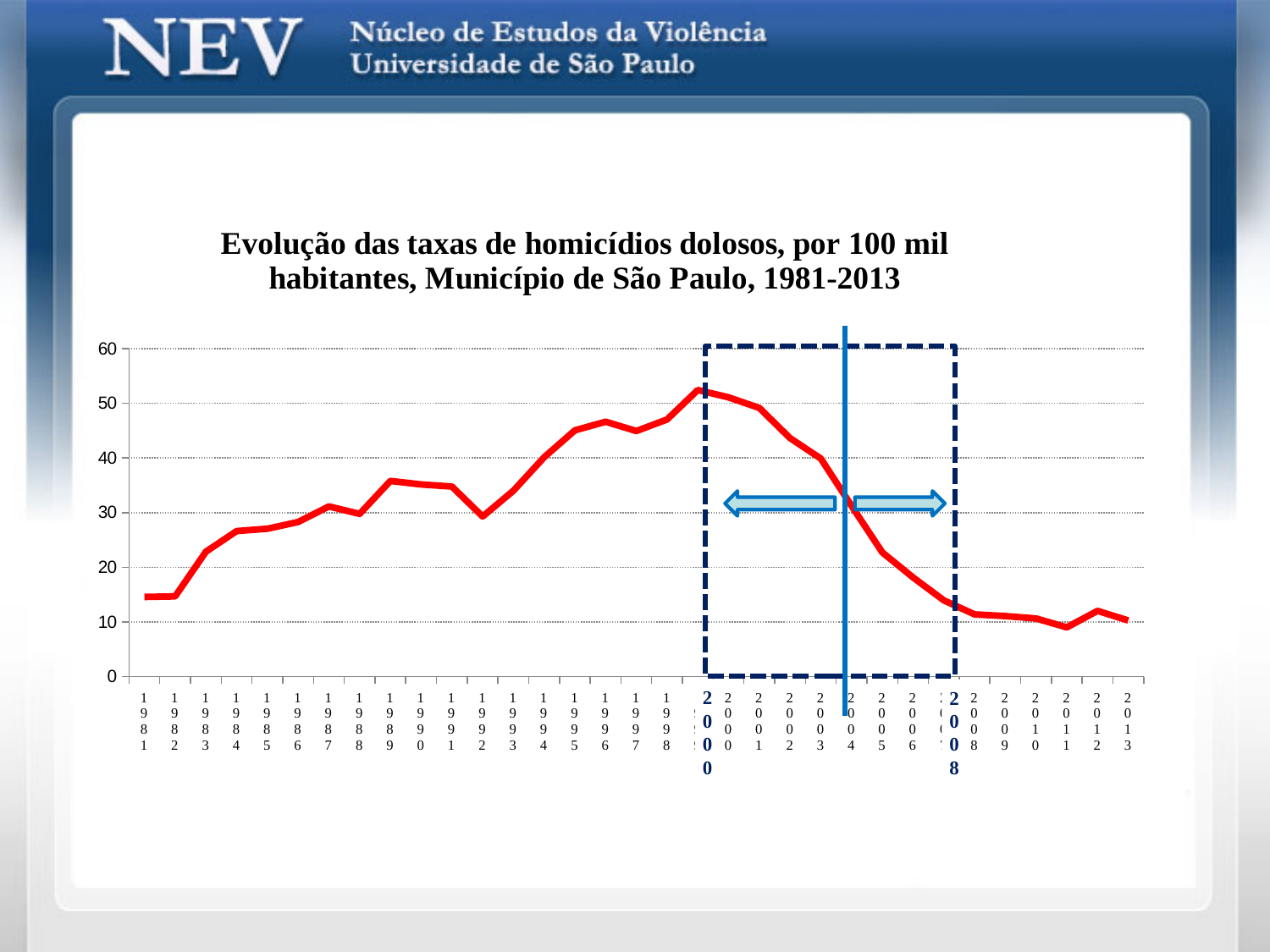
Is the value for 1999 greater or less than 50? greater In which year does the homicide rate reach its lowest point? 2011 Is the value for 1995 greater or less than 40? greater How many years are plotted along the x axis of the chart? 33 Is the value for 2005 greater or less than 30? less Which year has the higher homicide rate, 1990 or 2000? 2000 What is the title of the chart? Evolução das taxas de homicídios dolosos, por 100 mil habitantes, Município de São Paulo, 1981-2013 In which year does the homicide rate reach its highest point? 1999 What kind of chart is shown on the slide? line chart Does the homicide rate rise or fall between 2000 and 2013? fall